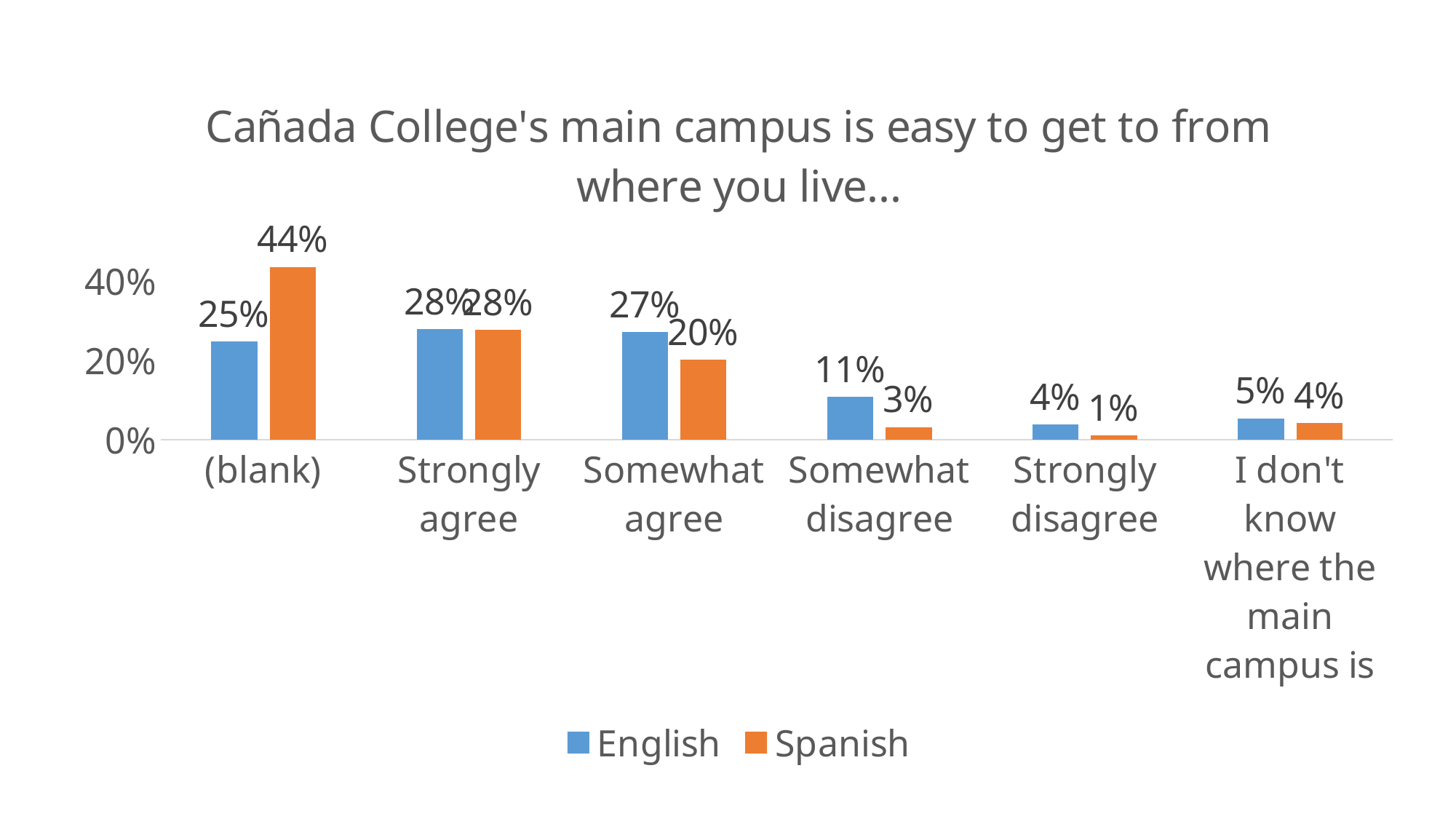
What kind of chart is shown on the slide? Bar chart What is the Spanish value for Somewhat disagree? 3% What is the Spanish value for (blank)? 44% What is the difference between the Spanish and English values for (blank)? 19% What is the English value for Somewhat agree? 27% How many series does the legend list? 2 Which colour represents the Spanish series? Orange Which is larger for Somewhat agree, the English value or the Spanish value? English Which category has the highest Spanish value? (blank) How many categories are shown on the x axis? 6 Which category has the lowest Spanish value? Strongly disagree What is the English value for Strongly disagree? 4%